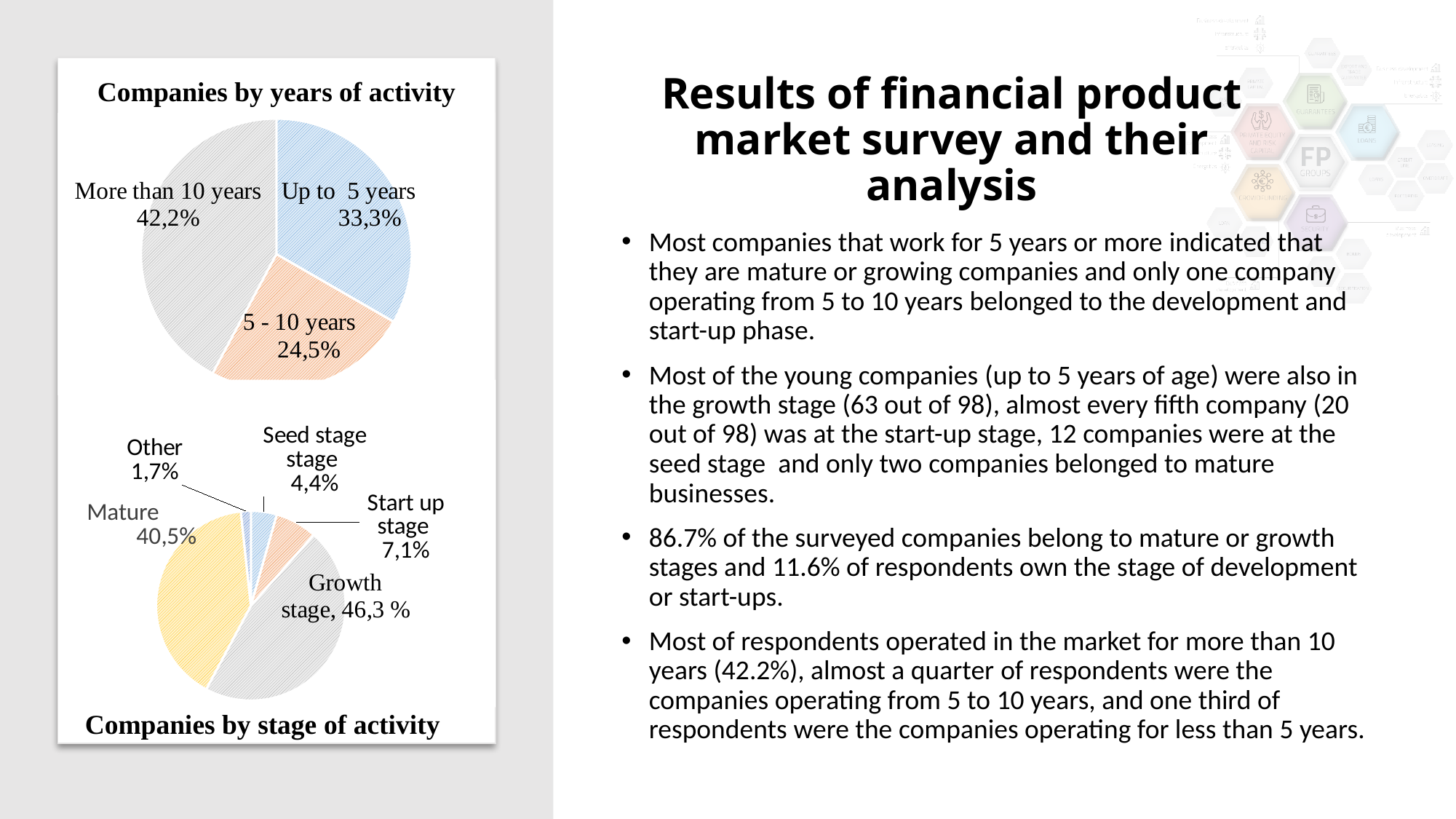
In the 'Companies by years of activity' chart, how many slices does the pie have? 3 What kind of chart is 'Companies by years of activity'? Pie chart In the 'Companies by stage of activity' chart, what is the difference between the Mature share and the Seed stage share? 36,1% In the 'Companies by stage of activity' chart, which category has the smallest share? Other In the 'Companies by stage of activity' chart, which is larger: Mature or Growth stage? Growth stage In the 'Companies by years of activity' chart, what share of companies have been active for more than 10 years? 42,2% In the 'Companies by stage of activity' chart, how many categories are shown? 5 In the 'Companies by stage of activity' chart, what share of companies are in the start up stage? 7,1% In the 'Companies by stage of activity' chart, what share of companies are in the growth stage? 46,3 % In the 'Companies by years of activity' chart, which category has the largest share? More than 10 years In the 'Companies by years of activity' chart, which category has the smallest share? 5 - 10 years In the 'Companies by years of activity' chart, what share of companies have been active for up to 5 years? 33,3%